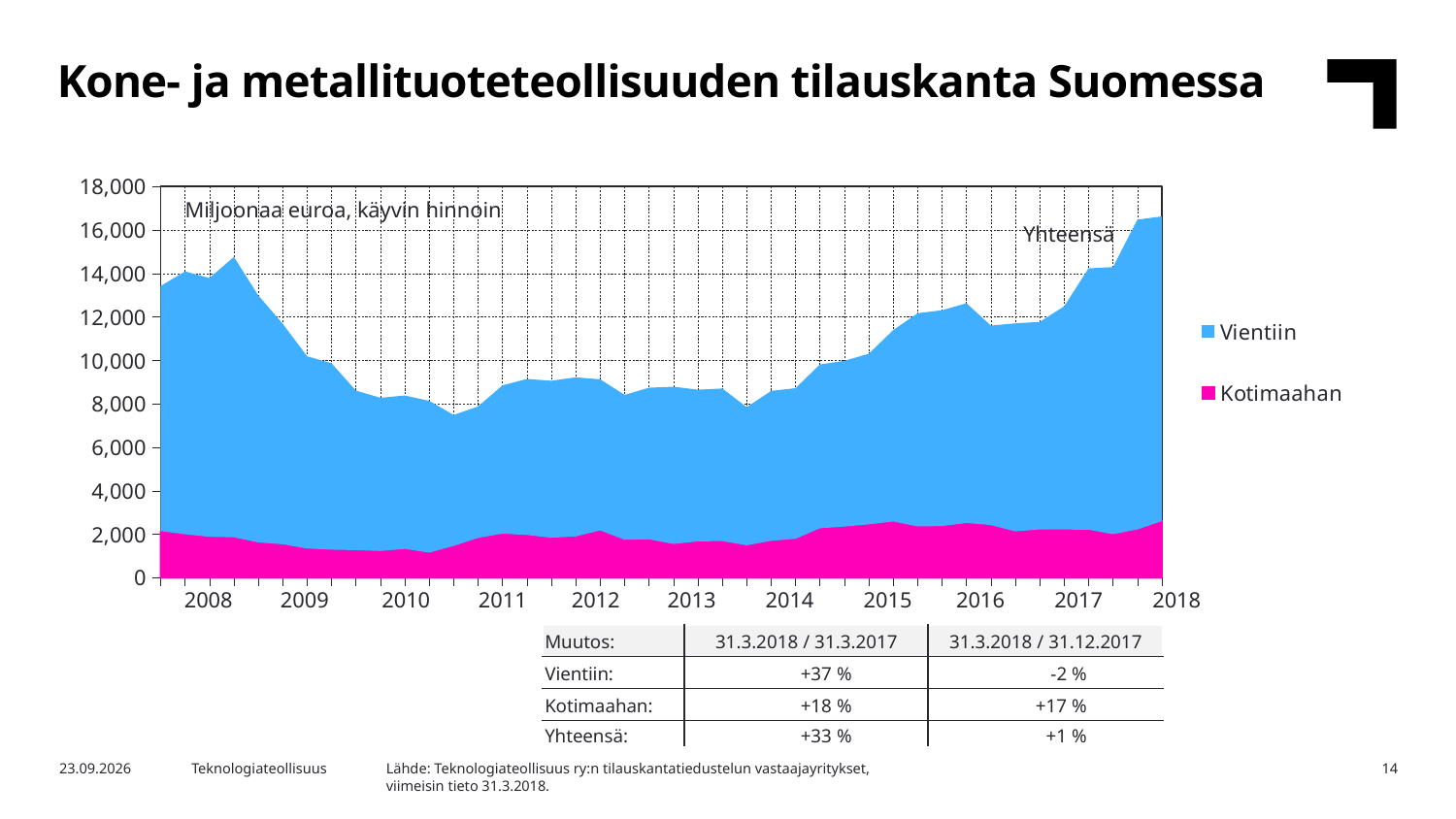
What unit is stated in the annotation inside the chart? Miljoonaa euroa, käyvin hinnoin Does the total order book rise or fall between 2016 and 2018? Rise Is the Kotimaahan value at the start of 2016 greater or less than 4,000? less Is the total (Yhteensä) value at the start of 2018 greater or less than 16,000? greater How many series does the chart legend list? 2 What kind of chart is shown on the slide? Stacked area chart What are the two series named in the chart legend? Vientiin and Kotimaahan According to the table below the chart, what is the change in Vientiin for 31.3.2018 / 31.3.2017? +37 % Does the total order book rise or fall between 2008 and 2010? Fall Which series is larger at the start of 2018, Vientiin or Kotimaahan? Vientiin Is the total (Yhteensä) value at the start of 2010 greater or less than 10,000? less How many year labels are shown on the x axis? 11